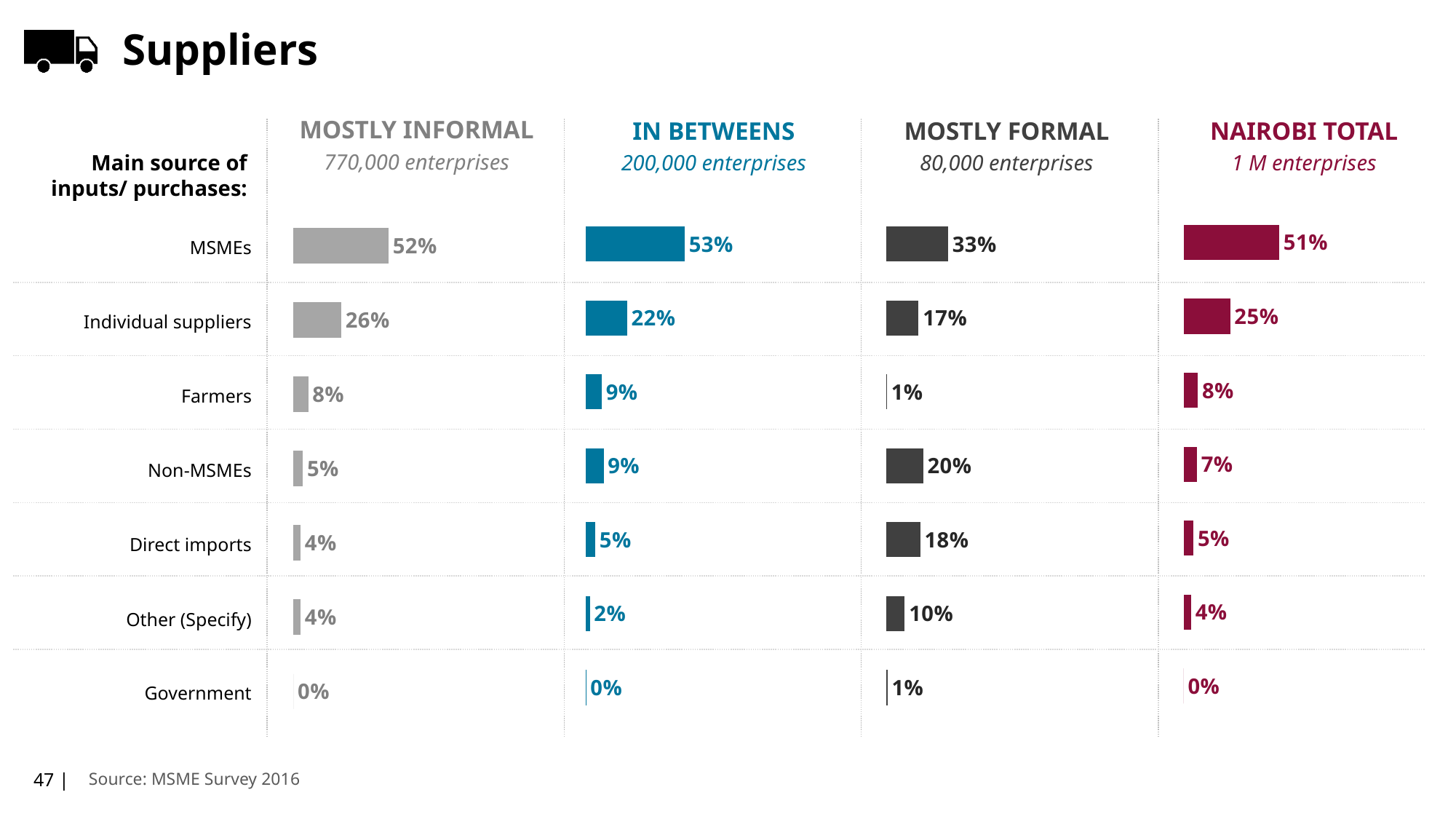
In the Mostly Formal chart, what is the difference between the values for MSMEs and Individual suppliers? 16% In the In Betweens chart, which source of inputs has the lowest value? Government How many enterprises does the In Betweens column header say it covers? 200,000 enterprises In the Nairobi Total chart, what is the value for Farmers? 8% In the Mostly Formal chart, which source of inputs has the highest value? MSMEs How many sources of inputs/purchases are listed in each chart? 7 What kind of chart is used to show the values on this slide? Bar chart In the Mostly Formal chart, what is the value for Non-MSMEs? 20% In the Nairobi Total chart, what is the difference between the values for MSMEs and Individual suppliers? 26% Which is larger: the value for Direct imports in the Mostly Formal chart or in the Mostly Informal chart? Mostly Formal In the In Betweens chart, what is the value for Individual suppliers? 22% In the Mostly Informal chart, what is the value for MSMEs? 52%